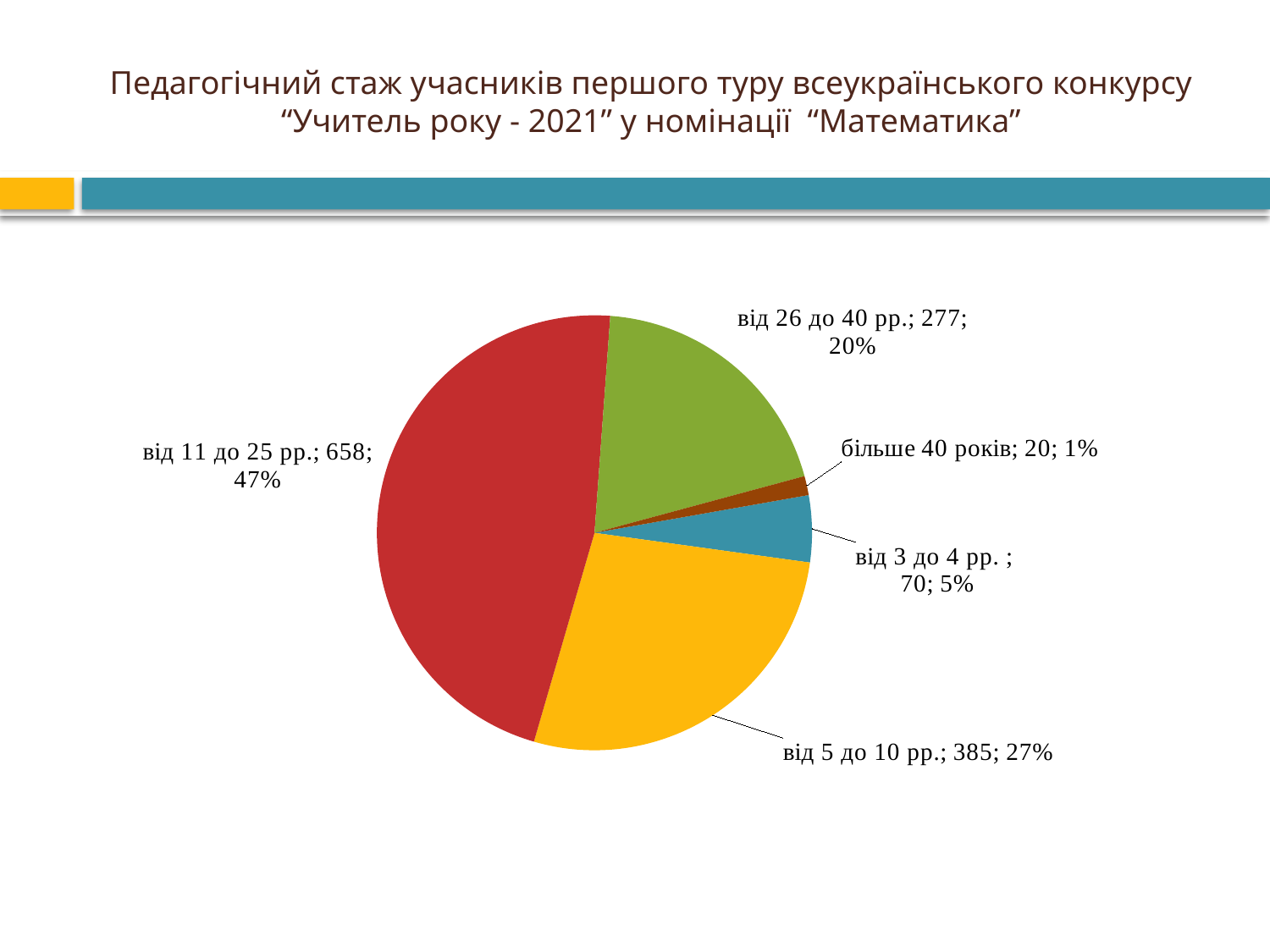
What is the value for "більше 40 років"? 20 Which category has the smallest slice? більше 40 років What share of the pie does "від 3 до 4 рр." represent? 5% How many slices does the pie chart have? 5 What share of the pie does "від 11 до 25 рр." represent? 47% What is the value for "від 5 до 10 рр."? 385 What is the difference between the values for "від 11 до 25 рр." and "від 5 до 10 рр."? 273 What is the value for "від 26 до 40 рр."? 277 What kind of chart is shown on the slide? pie chart Which is larger, the value for "від 26 до 40 рр." or the value for "від 3 до 4 рр."? від 26 до 40 рр. Which category has the largest slice? від 11 до 25 рр. What is the value for "від 11 до 25 рр."? 658